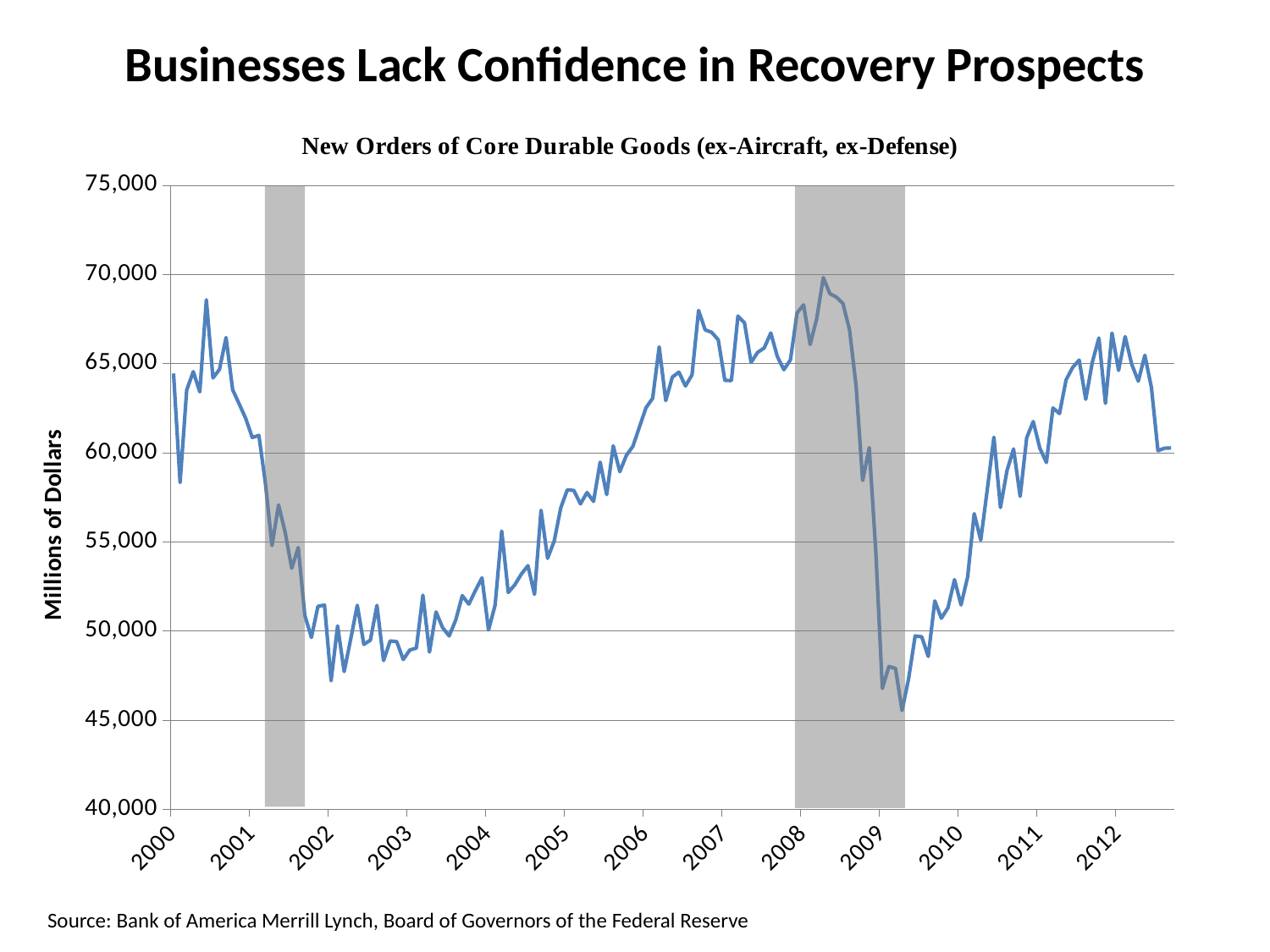
Is the peak value of the line in 2008 greater or less than 65,000? greater What kind of chart is shown on the slide? Line chart Is the value at the start of 2010 greater or less than 55,000? less How many year labels are shown along the x axis? 13 What is the label on the vertical axis of the chart? Millions of Dollars What is the title of the chart? New Orders of Core Durable Goods (ex-Aircraft, ex-Defense) Is the lowest value of the line, reached in 2009, greater or less than 50,000? less Does the line rise or fall between 2009 and 2011? Rises Does the line rise or fall between 2008 and 2009? Falls In which year does the line reach its highest point? 2008 In which year does the line reach its lowest point? 2009